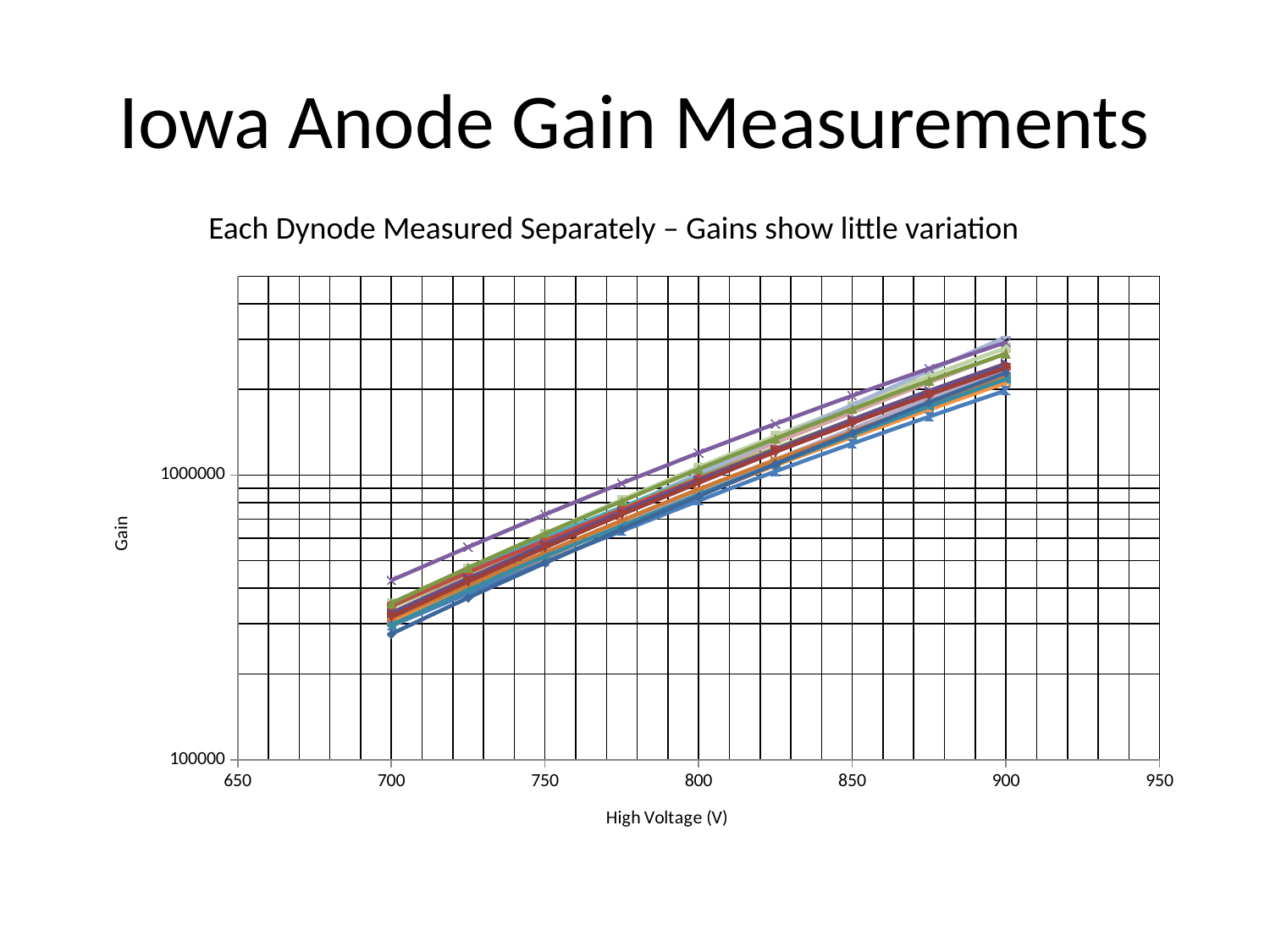
Are the gain values at 700 V greater or less than 100000? greater What is the lowest value shown on the y axis? 100000 What kind of chart is shown on the slide? line chart At how many high voltage settings are gain measurements plotted for each series? 9 Is the gain at 900 V larger or smaller than the gain at 700 V? larger Are the gain values at 750 V greater or less than 1000000? less Are the gain values at 850 V greater or less than 1000000? greater What is the label of the y axis? Gain Do the gain values rise or fall as the high voltage increases along the x axis? rise What is the label of the x axis? High Voltage (V)